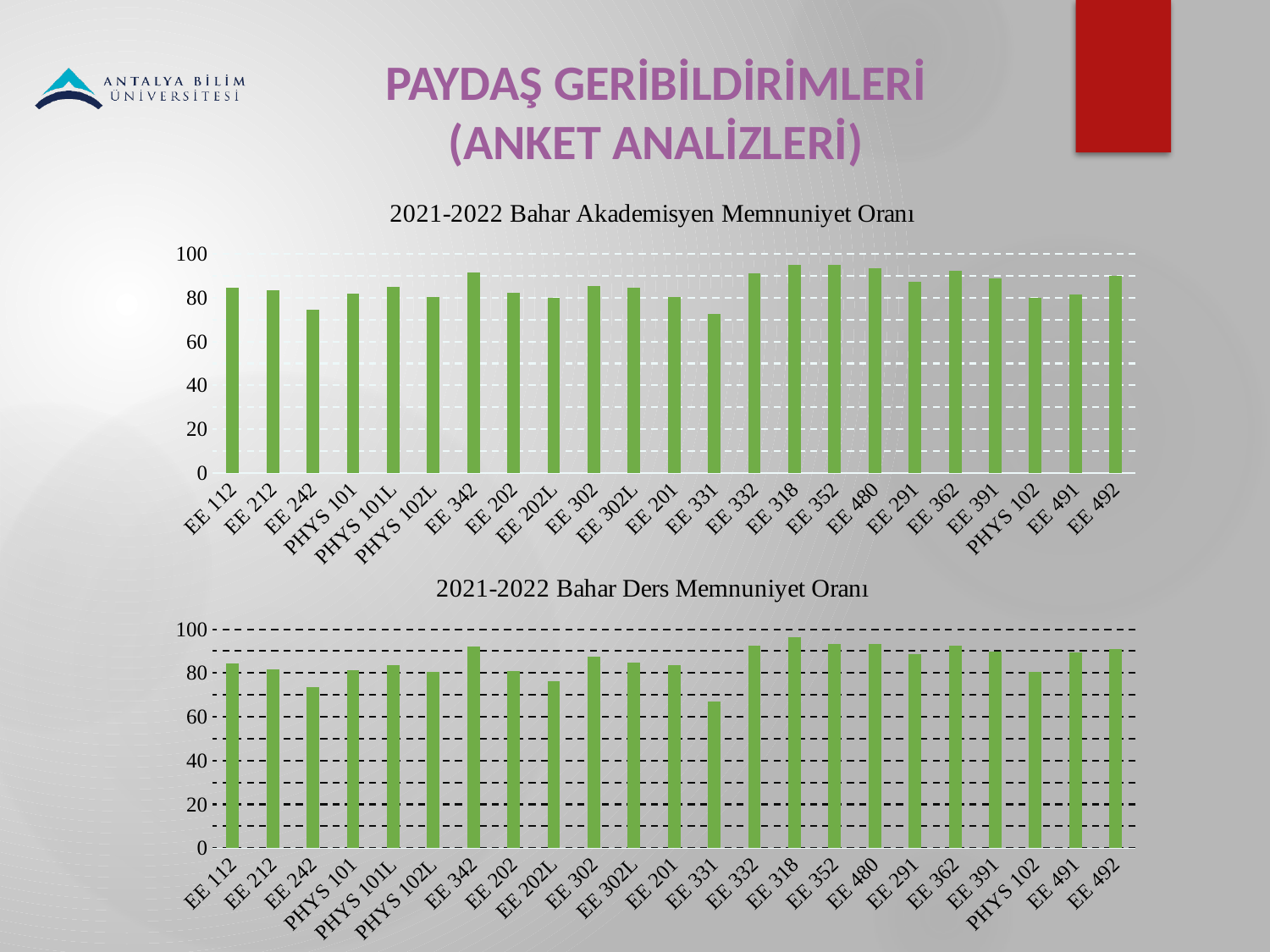
In the '2021-2022 Bahar Ders Memnuniyet Oranı' chart, which is larger, the value for EE 331 or the value for EE 318? EE 318 In the '2021-2022 Bahar Akademisyen Memnuniyet Oranı' chart, is the value for EE 242 greater or less than 80? less In the '2021-2022 Bahar Akademisyen Memnuniyet Oranı' chart, which category has the lowest value? EE 331 In the '2021-2022 Bahar Ders Memnuniyet Oranı' chart, which category has the lowest value? EE 331 In the '2021-2022 Bahar Akademisyen Memnuniyet Oranı' chart, is the value for EE 318 greater or less than 80? greater In the '2021-2022 Bahar Ders Memnuniyet Oranı' chart, is the value for EE 331 greater or less than 80? less How many categories are shown on the x axis of the '2021-2022 Bahar Ders Memnuniyet Oranı' chart? 23 In the '2021-2022 Bahar Akademisyen Memnuniyet Oranı' chart, which is larger, the value for EE 242 or the value for EE 342? EE 342 What is the maximum value shown on the y axis of the '2021-2022 Bahar Ders Memnuniyet Oranı' chart? 100 What is the title of the top chart on the slide? 2021-2022 Bahar Akademisyen Memnuniyet Oranı What type of chart is the '2021-2022 Bahar Akademisyen Memnuniyet Oranı' chart? bar chart